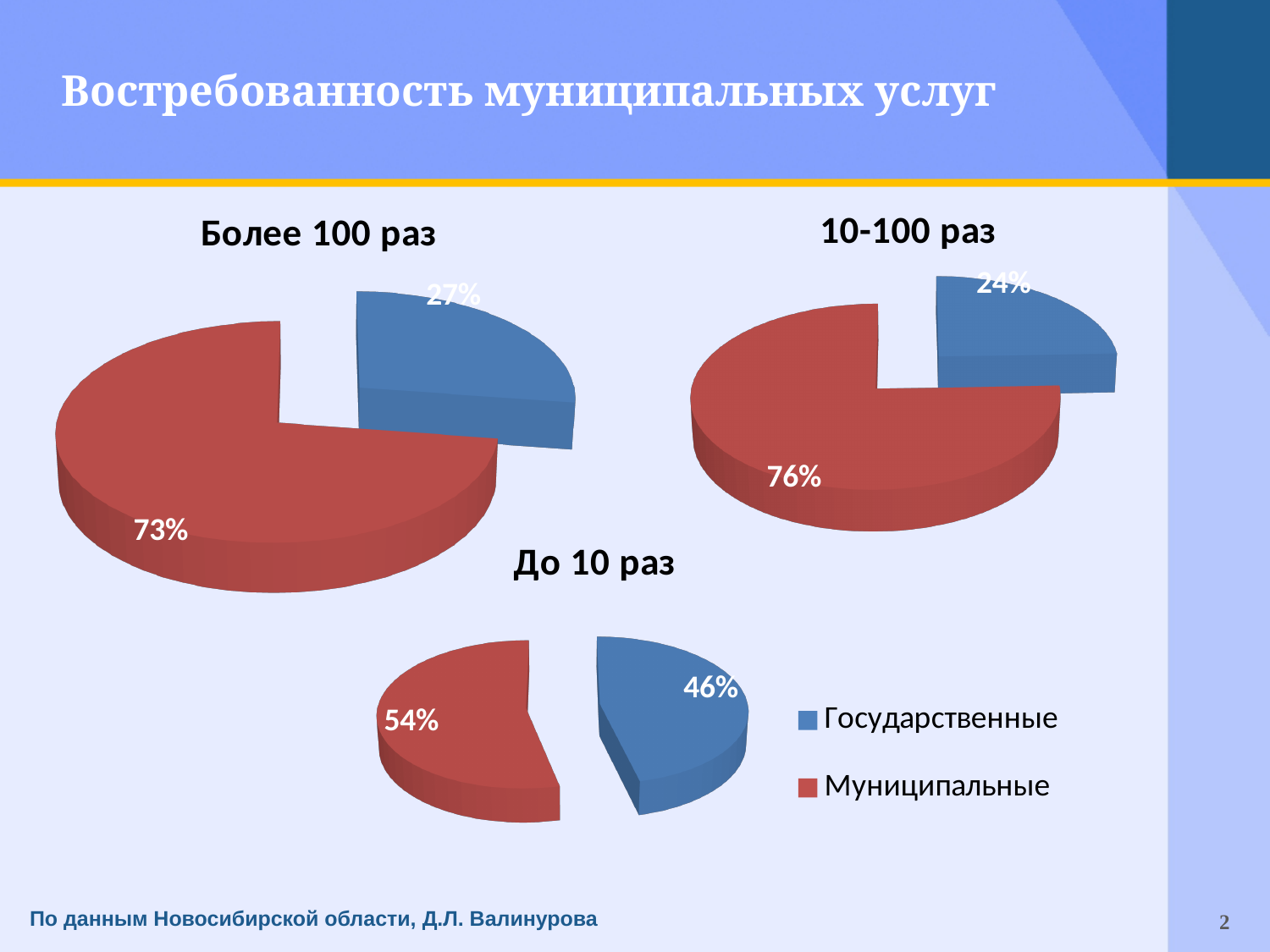
In the chart titled "Более 100 раз", which slice is the largest? Муниципальные What kind of chart is the chart titled "До 10 раз"? Pie chart How many entries does the legend on the slide list? 2 In the chart titled "10-100 раз", which is larger: Государственные or Муниципальные? Муниципальные In the chart titled "Более 100 раз", what share does Муниципальные have? 73% In the chart titled "10-100 раз", what share does Государственные have? 24% In the chart titled "До 10 раз", what is the difference between the Муниципальные and Государственные shares? 8% In the chart titled "До 10 раз", what share does Муниципальные have? 54% In the chart titled "10-100 раз", which slice is the smallest? Государственные